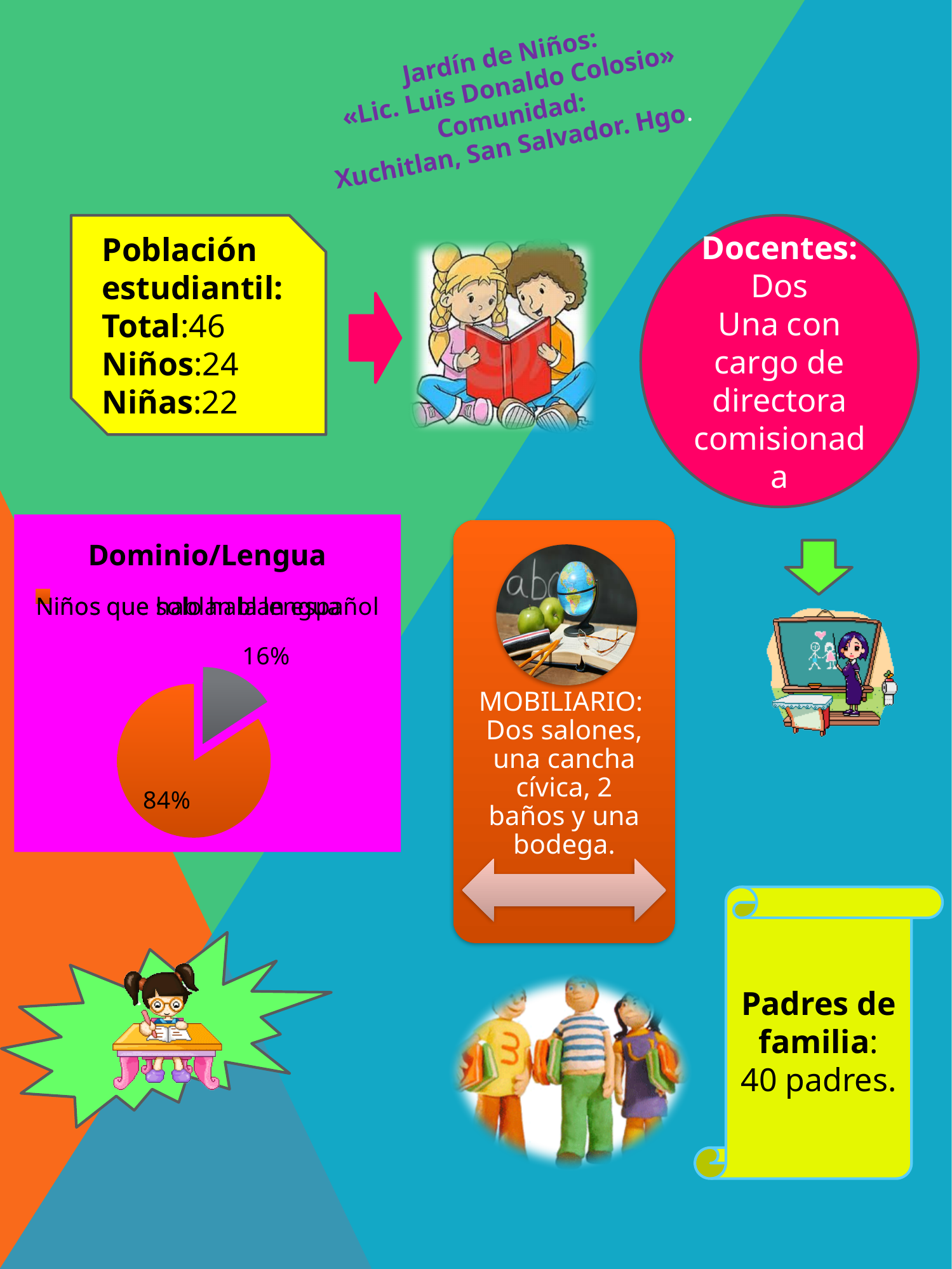
How many slices does the Dominio/Lengua pie chart have? 2 What is the value of the gray slice in the Dominio/Lengua pie chart? 16% Is the gray slice of the Dominio/Lengua pie chart greater or less than 50%? less What colour is the largest slice of the Dominio/Lengua pie chart? orange What is the difference in percentage points between the two slices of the Dominio/Lengua pie chart? 68 What is the title of the pie chart? Dominio/Lengua What is the value of the orange slice in the Dominio/Lengua pie chart? 84% In the Dominio/Lengua pie chart, which slice is larger, the orange one or the gray one? the orange one What is the value of the largest slice in the Dominio/Lengua pie chart? 84% What is the value of the smallest slice in the Dominio/Lengua pie chart? 16% What kind of chart is shown in the Dominio/Lengua box? pie chart